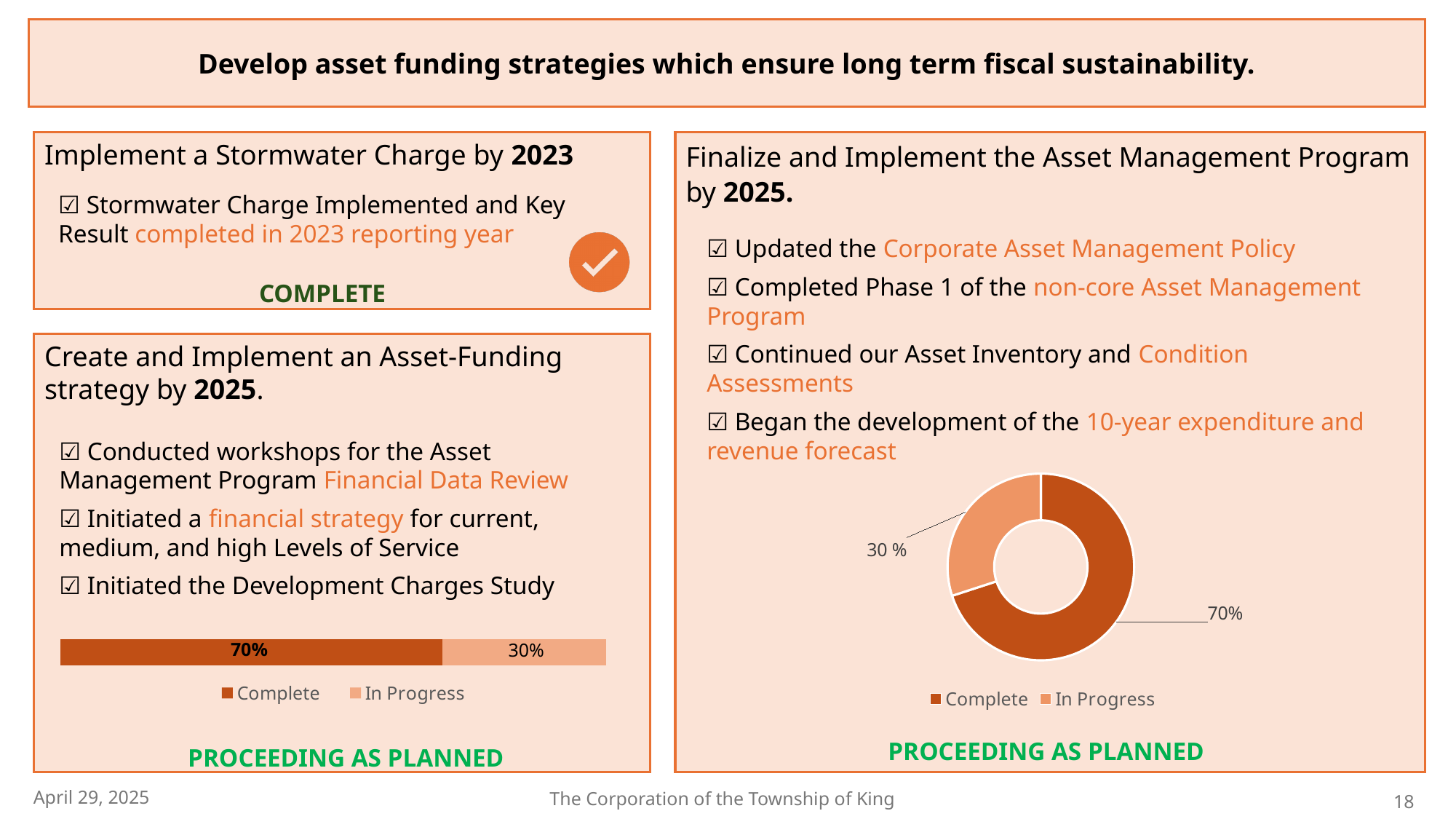
In the donut chart on the right side of the slide, what share is labelled for In Progress? 30 % What kind of chart is shown on the right side of the slide? Donut chart In the donut chart on the right side of the slide, what share is labelled for Complete? 70% How many series does the legend of the bar chart in the bottom-left box list? 2 In the bar chart in the bottom-left box, what is the value for Complete? 70% In the bar chart in the bottom-left box, what is the total of the two segments of the stacked bar? 100% In the donut chart on the right side of the slide, what colour is the In Progress slice? Light orange In the bar chart in the bottom-left box, what is the difference between the Complete and In Progress values? 40% In the bar chart in the bottom-left box, what is the value for In Progress? 30% In the donut chart on the right side of the slide, which slice is the largest? Complete What kind of chart is shown in the bottom-left box? Bar chart In the bar chart in the bottom-left box, which segment is larger, Complete or In Progress? Complete